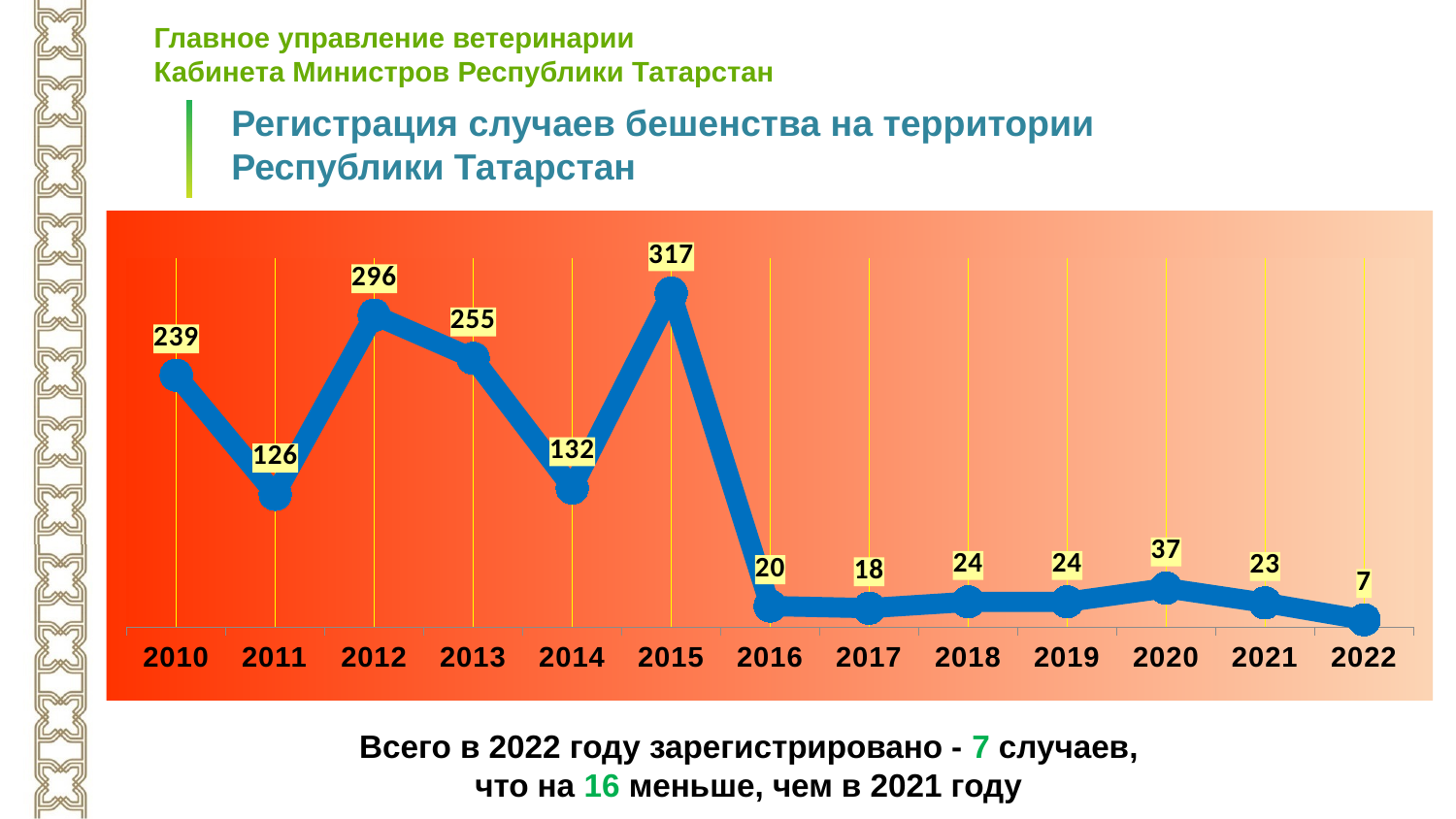
What type of chart is shown on the slide? line chart Which is larger, the value for 2013 or the value for 2014? 2013 What is the title of the chart? Регистрация случаев бешенства на территории Республики Татарстан What is the value for 2020? 37 Which year has the lowest value? 2022 Do the values rise or fall from 2016 to 2022 overall? fall What is the difference between the values for 2015 and 2012? 21 How many years are plotted on the x axis? 13 What is the difference between the values for 2021 and 2022? 16 What is the value for 2015? 317 Which year has the highest value? 2015 What is the value for 2011? 126